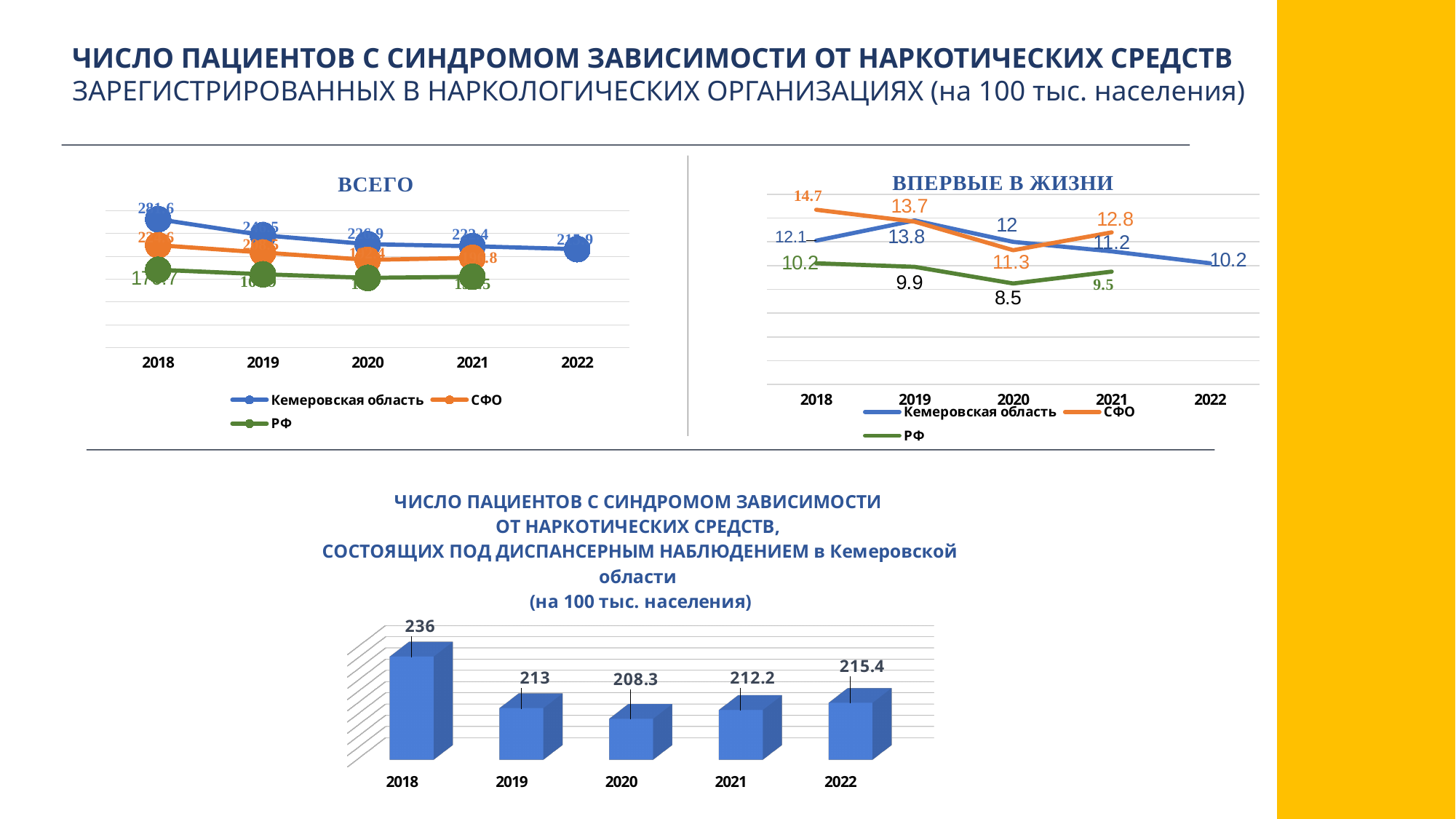
In the chart titled 'ВПЕРВЫЕ В ЖИЗНИ', what is the difference between the СФО values for 2018 and 2021? 1.9 In the bottom bar chart, which year has the lowest value? 2020 In the bottom bar chart, what is the difference between the values for 2018 and 2019? 23 In the chart titled 'ВПЕРВЫЕ В ЖИЗНИ', what is the value for РФ in 2020? 8.5 In the chart titled 'ВПЕРВЫЕ В ЖИЗНИ', in which year is the СФО value highest? 2018 In the bottom bar chart, which is larger: the value for 2021 or the value for 2022? 2022 In the chart titled 'ВСЕГО', what is the value for Кемеровская область in 2018? 281.6 What kind of chart is the bottom chart on the slide? Bar chart In the bottom bar chart, what is the value for 2018? 236 In the bottom bar chart, which year has the highest value? 2018 How many series does the legend of the chart titled 'ВСЕГО' list? 3 In the chart titled 'ВПЕРВЫЕ В ЖИЗНИ', what is the value for Кемеровская область in 2022? 10.2